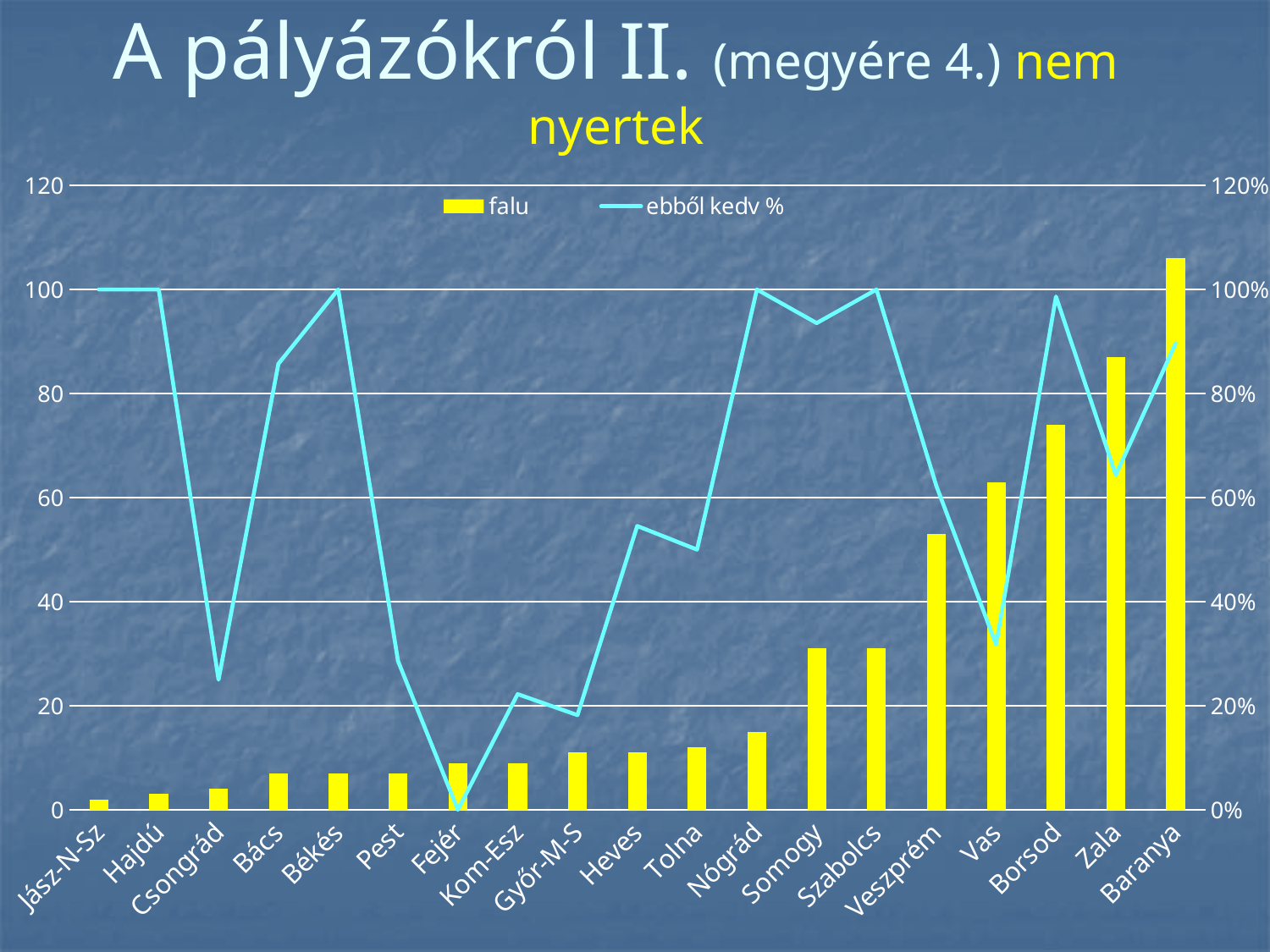
Which has the larger 'falu' bar, Vas or Somogy? Vas How many series does the legend list? 2 What is the 'ebből kedv %' value for Fejér? 0% Is the 'falu' value for Somogy greater or less than 40? less Is the 'falu' value for Baranya greater or less than 100? greater Do the 'falu' bars generally rise or fall from left to right along the x axis? rise What is the 'ebből kedv %' value for Hajdú? 100% How many counties (categories) are shown on the x axis? 19 What kind of chart is shown on the slide? A combined bar and line chart Which county has the lowest value on the 'ebből kedv %' line? Fejér Which county has the lowest 'falu' bar? Jász-N-Sz Which county has the highest 'falu' bar? Baranya